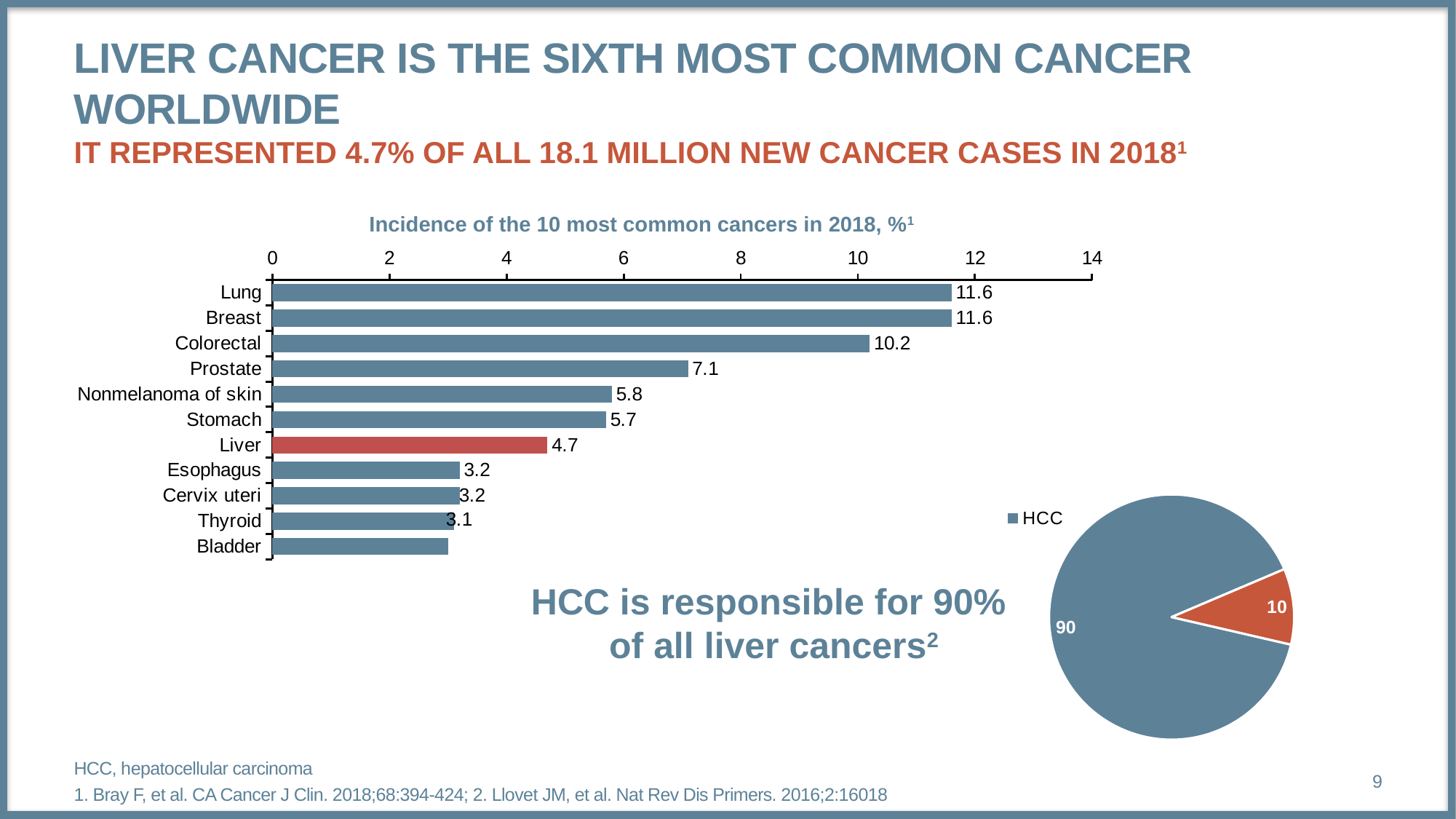
In the bar chart 'Incidence of the 10 most common cancers in 2018, %', what is the value for Nonmelanoma of skin? 5.8 In the bar chart 'Incidence of the 10 most common cancers in 2018, %', which category's bar is coloured differently (red) from the others? Liver How many categories are shown in the bar chart 'Incidence of the 10 most common cancers in 2018, %'? 11 In the bar chart 'Incidence of the 10 most common cancers in 2018, %', which is larger, the value for Prostate or the value for Stomach? Prostate In the bar chart 'Incidence of the 10 most common cancers in 2018, %', what is the difference between the values for Colorectal and Prostate? 3.1 What kind of chart is the chart titled 'Incidence of the 10 most common cancers in 2018, %'? bar chart How many entries does the legend of the pie chart on the right of the slide list? 1 In the bar chart 'Incidence of the 10 most common cancers in 2018, %', what is the value for Liver? 4.7 In the pie chart on the right of the slide, what is the value of the HCC slice? 90 In the bar chart 'Incidence of the 10 most common cancers in 2018, %', is the value for Bladder greater or less than 4? less In the bar chart 'Incidence of the 10 most common cancers in 2018, %', what is the value for Colorectal? 10.2 In the bar chart 'Incidence of the 10 most common cancers in 2018, %', what is the difference between the values for Lung and Liver? 6.9